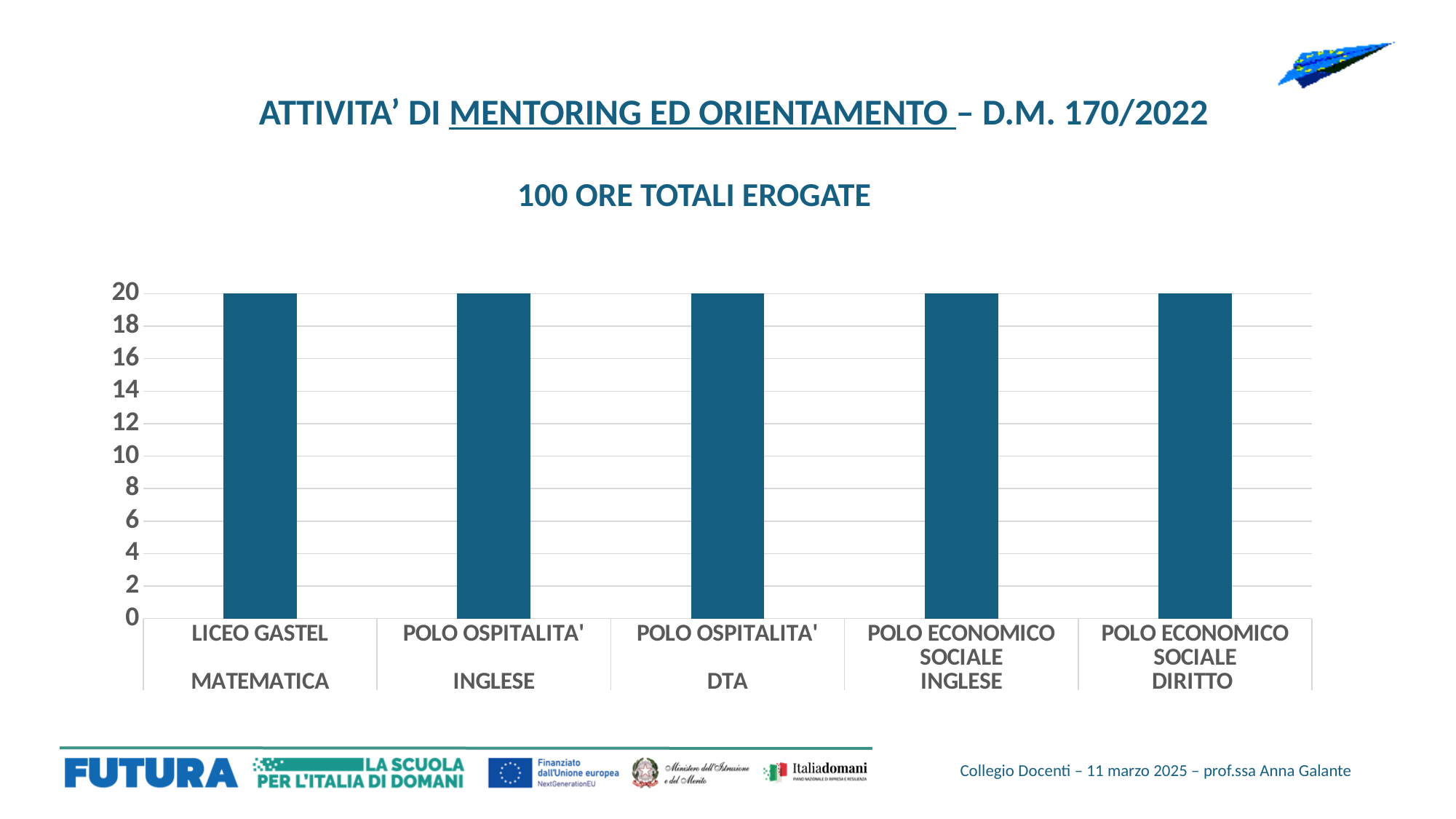
Is the value for POLO ECONOMICO SOCIALE INGLESE greater or less than 10? greater What kind of chart is shown on the slide? bar chart Do the values rise, fall or stay the same across the categories from left to right? stay the same Is the value for POLO OSPITALITA' DTA greater or less than 16? greater What is the highest value shown on the y axis? 20 What is the title shown above the chart? 100 ORE TOTALI EROGATE What is the value for POLO OSPITALITA' INGLESE? 20 What is the value for LICEO GASTEL MATEMATICA? 20 What is the value for POLO OSPITALITA' DTA? 20 What is the difference between the values for LICEO GASTEL MATEMATICA and POLO ECONOMICO SOCIALE INGLESE? 0 How many categories are shown on the x axis? 5 What is the value for POLO ECONOMICO SOCIALE DIRITTO? 20